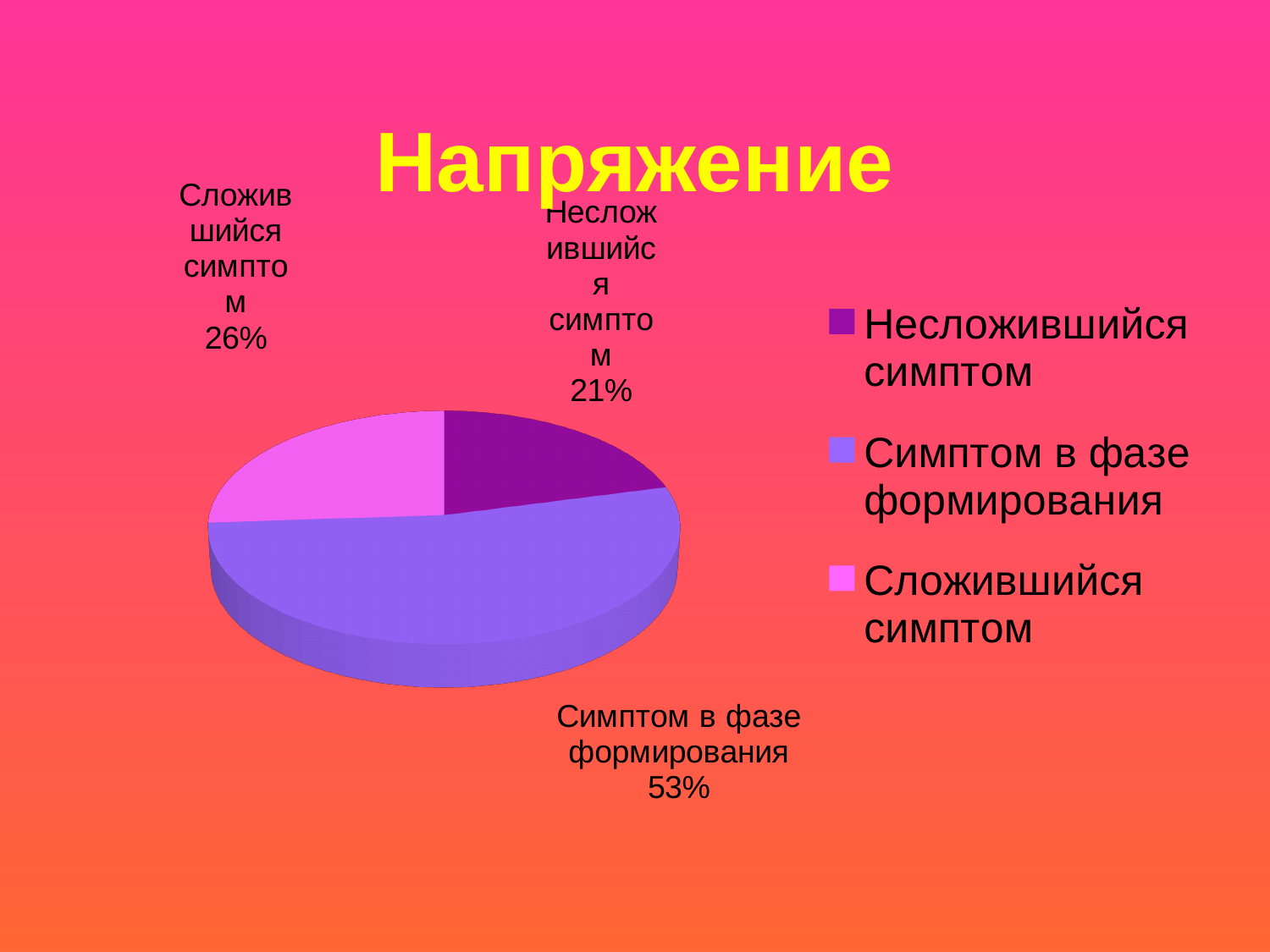
What is the difference in percentage points between "Симптом в фазе формирования" and "Сложившийся симптом"? 27 Which is larger: "Сложившийся симптом" or "Несложившийся симптом"? Сложившийся симптом Which category has the largest slice of the pie? Симптом в фазе формирования What kind of chart is shown on the slide? Pie chart What share of the pie does "Симптом в фазе формирования" take? 53% Which category has the smallest slice of the pie? Несложившийся симптом What is the value shown for "Сложившийся симптом"? 26% How many categories does the pie chart show? 3 What is the difference in percentage points between "Сложившийся симптом" and "Несложившийся симптом"? 5 What is the title of the chart? Напряжение Which legend entry is shown in the lightest pink colour? Сложившийся симптом What is the value shown for "Несложившийся симптом"? 21%